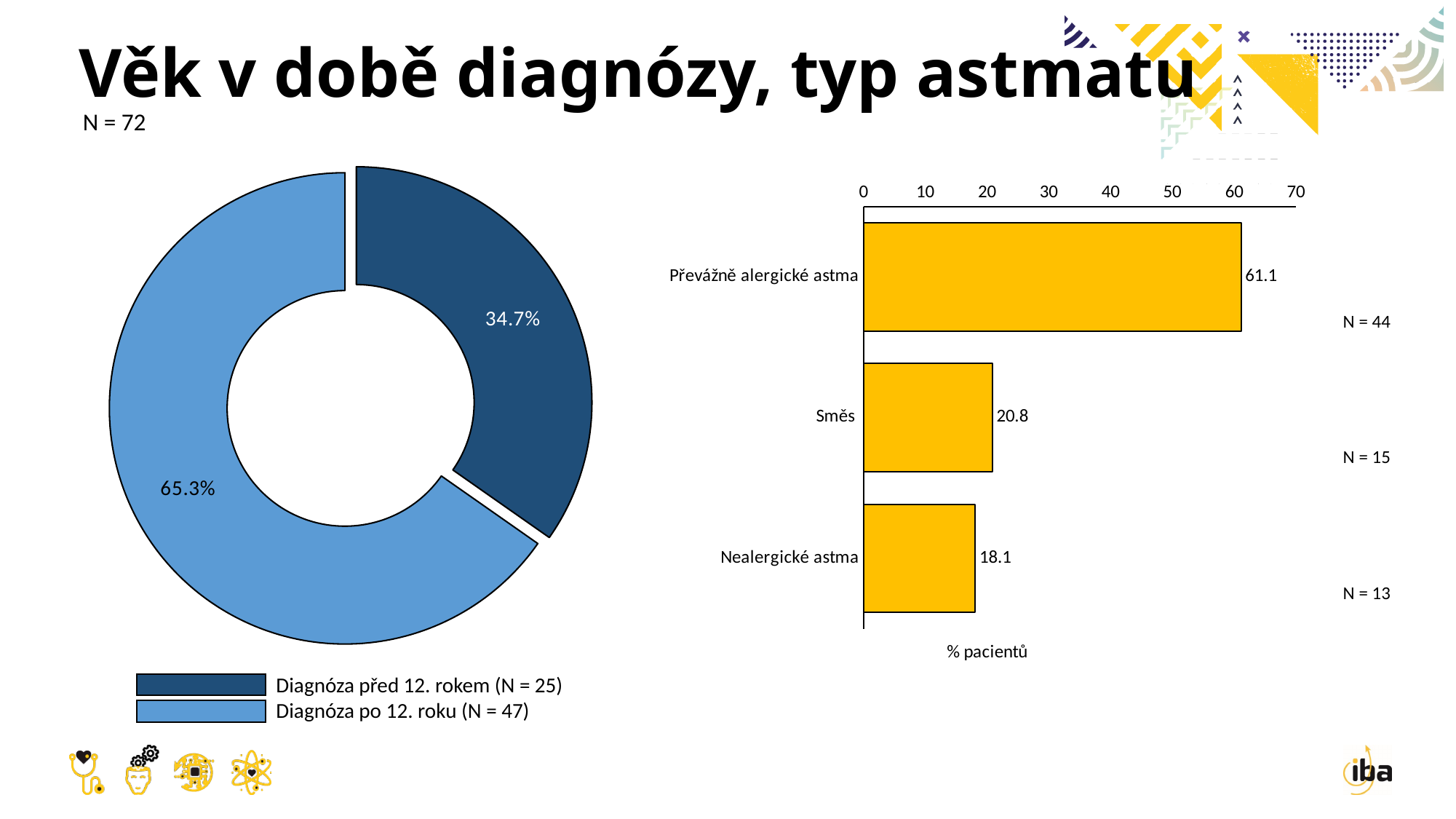
In the donut chart on the left, which category has the larger share? Diagnóza po 12. roku (N = 47) In the donut chart on the left, how many categories does the legend list? 2 In the bar chart on the right, which category has the highest value? Převážně alergické astma In the bar chart on the right, what is the difference between the values for 'Převážně alergické astma' and 'Směs'? 40.3 In the bar chart on the right, which category has the lowest value? Nealergické astma In the donut chart on the left, what share is labelled for 'Diagnóza po 12. roku (N = 47)'? 65.3% In the bar chart on the right, what is the value for 'Nealergické astma'? 18.1 In the bar chart on the right, what is the value for 'Směs'? 20.8 What kind of chart is shown on the right of the slide? Bar chart In the donut chart on the left, what share is labelled for 'Diagnóza před 12. rokem (N = 25)'? 34.7% What kind of chart is shown on the left of the slide? Pie (donut) chart In the bar chart on the right, what is the value for 'Převážně alergické astma'? 61.1